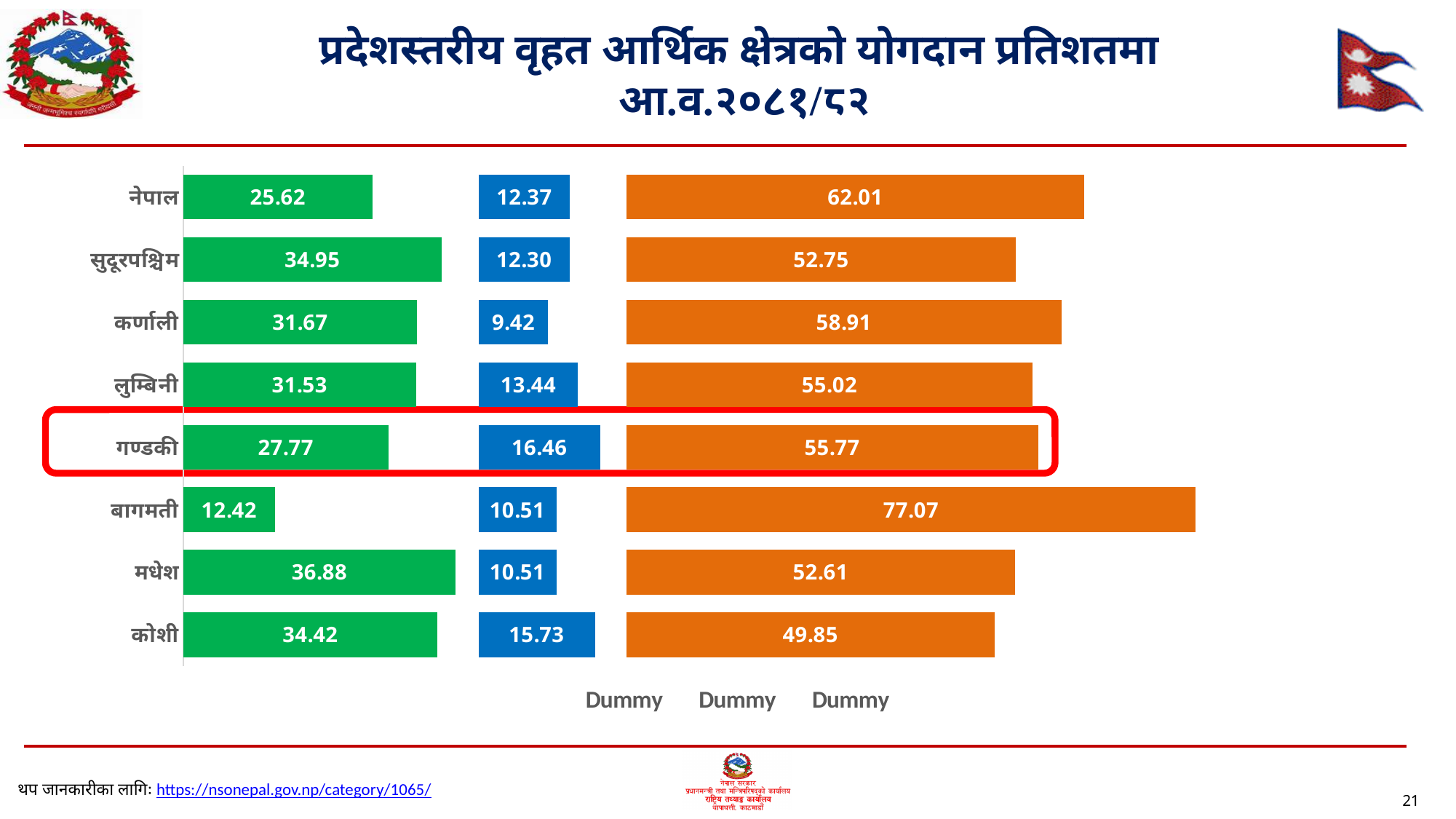
What is the difference between the orange bar values for बागमती and कोशी? 27.22 What is the value of the green bar for मधेश? 36.88 Which category has the highest orange bar value? बागमती What is the value of the blue bar for गण्डकी? 16.46 How many series does the legend list? 3 What is the value of the orange bar for नेपाल? 62.01 What kind of chart is shown on the slide? Bar chart Which category has the lowest blue bar value? कर्णाली How many categories are shown on the chart? 8 Which category has the lowest green bar value? बागमती What is the value of the orange bar for बागमती? 77.07 Which is larger, the green bar for सुदूरपश्चिम or the green bar for कोशी? सुदूरपश्चिम